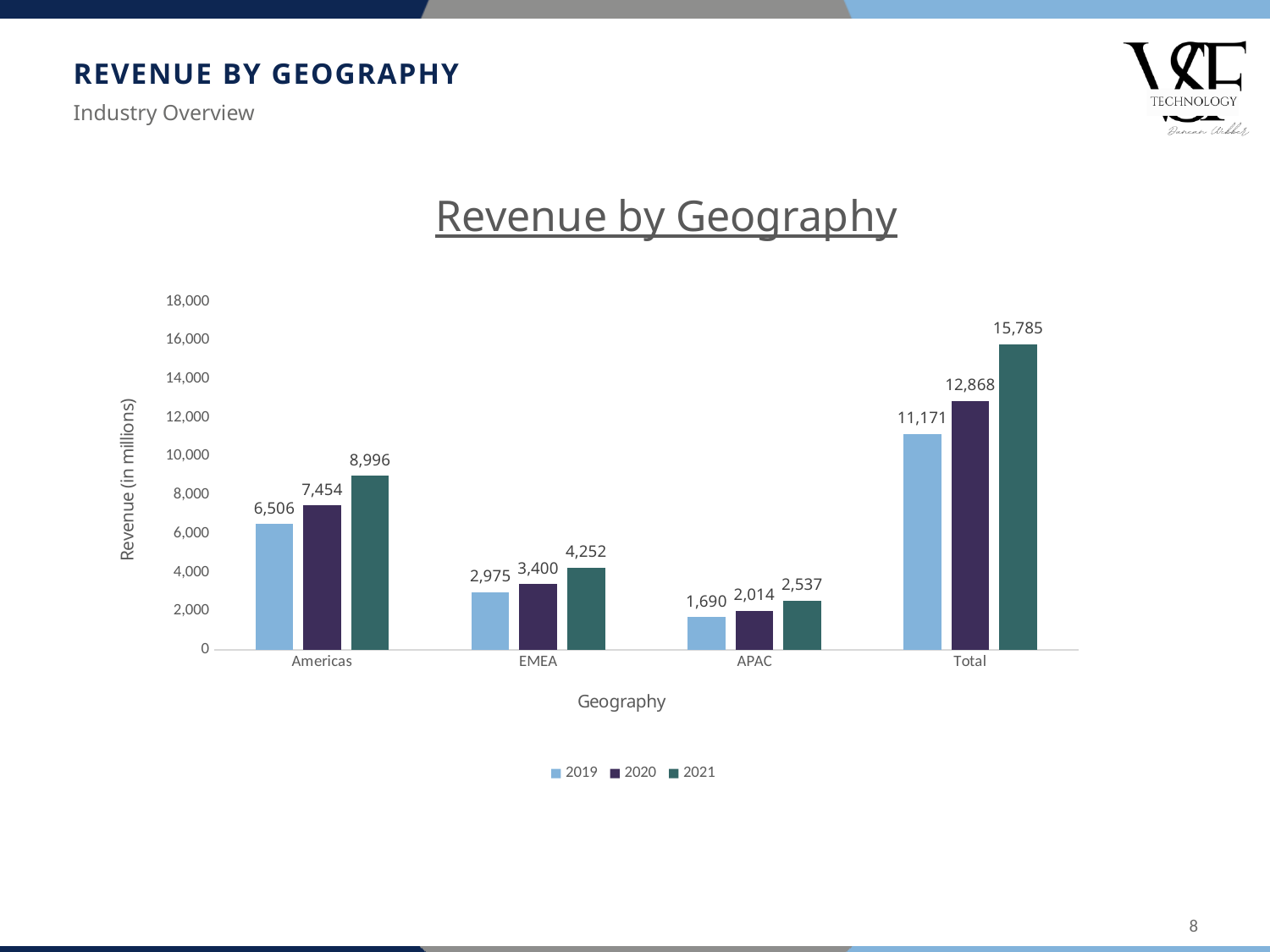
What is the 2021 revenue for the Americas? 8,996 What is the 2019 revenue for EMEA? 2,975 What is the difference between the 2021 and 2019 revenue for the Americas? 2,490 Which is larger: EMEA revenue in 2021 or APAC revenue in 2021? EMEA revenue in 2021 Excluding Total, which geography has the highest 2020 revenue? Americas What is the 2020 revenue for APAC? 2,014 What is the difference between the Total revenue in 2020 and 2019? 1,697 What is the Total revenue for 2021? 15,785 Does the Total revenue rise or fall from 2019 to 2021? Rise How many series does the legend list? 3 What kind of chart is shown on the slide? Bar chart Which geography has the lowest 2019 revenue? APAC